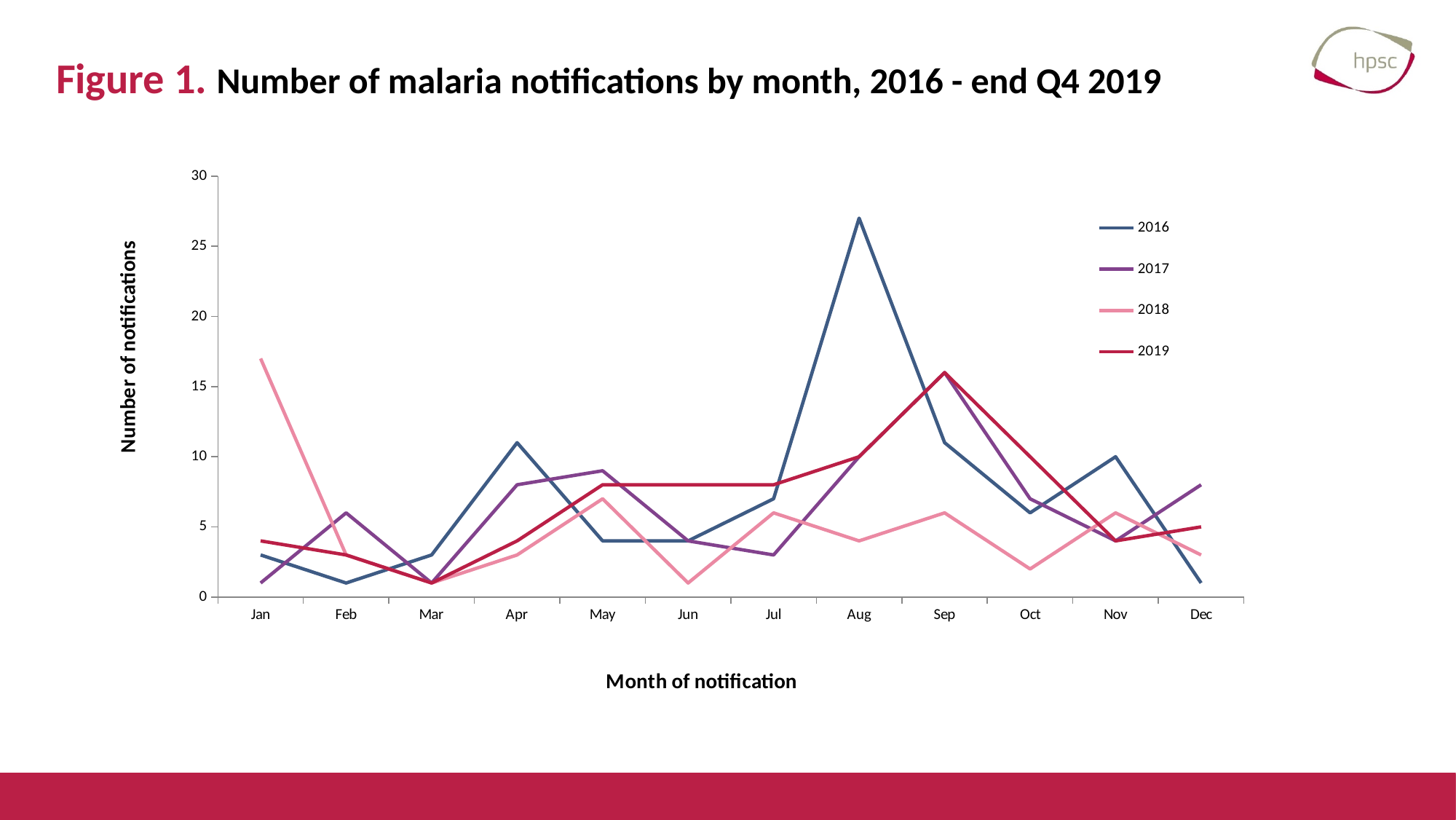
What is the label of the y axis? Number of notifications Which series has the larger value in Aug, 2016 or 2018? 2016 How many months are shown along the x axis? 12 Is the value for 2018 in Jan greater or less than 15? greater Which series has the larger value in Jan, 2018 or 2016? 2018 In which month did the 2019 series reach its highest number of notifications? Sep What type of chart is shown on the slide? line chart Is the value for 2018 in Jun greater or less than 5? less In which month did the 2018 series reach its highest number of notifications? Jan How many series does the legend list? 4 Is the value for 2016 in Aug greater or less than 25? greater In which month did the 2016 series reach its highest number of notifications? Aug